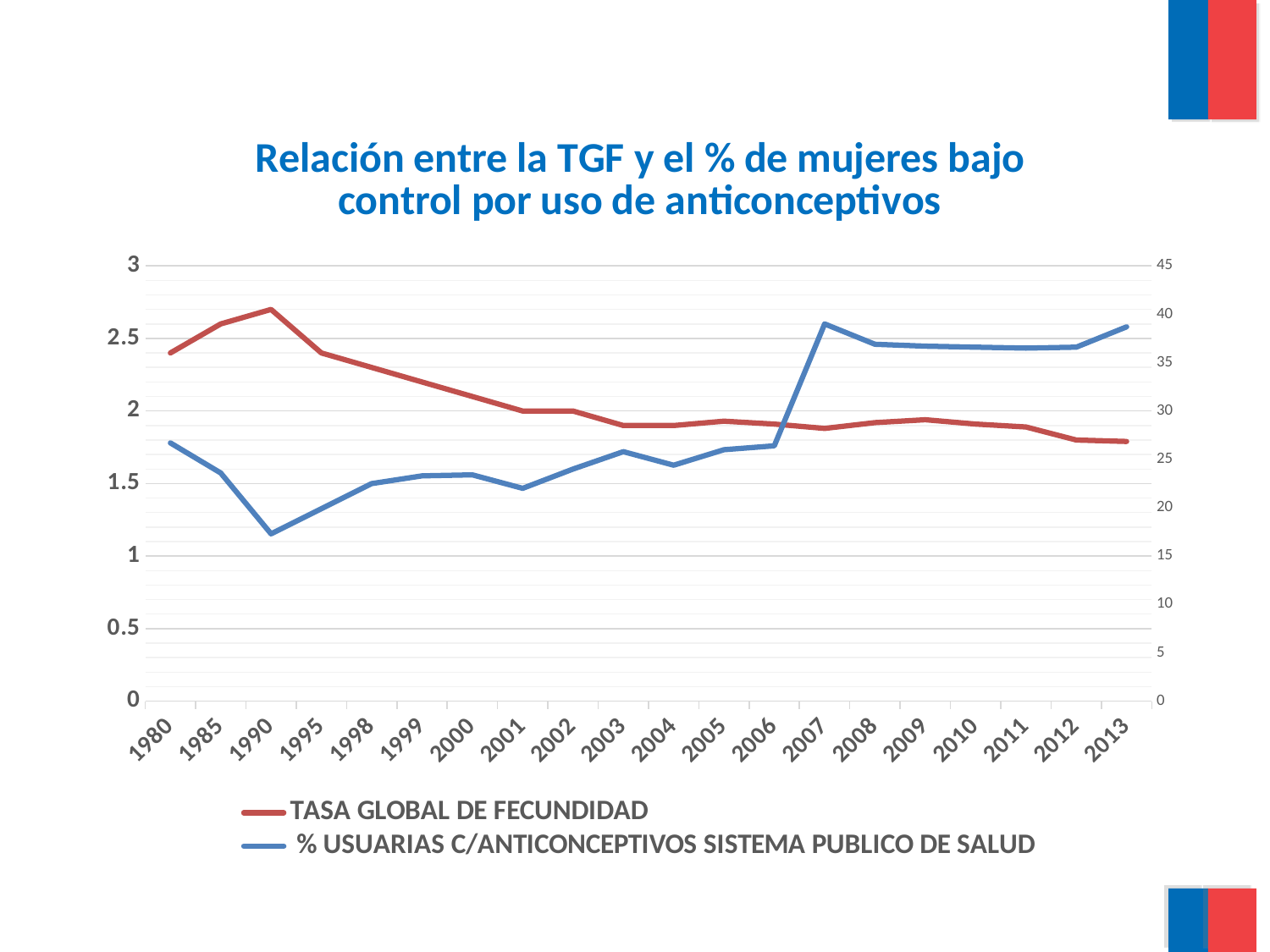
Which year has the larger TASA GLOBAL DE FECUNDIDAD value, 1985 or 2005? 1985 Is the TASA GLOBAL DE FECUNDIDAD value for 2013 greater or less than 2? less In which year does the TASA GLOBAL DE FECUNDIDAD line reach its highest value? 1990 Does the TASA GLOBAL DE FECUNDIDAD line overall rise or fall from 1980 to 2013? fall In which year does the % USUARIAS C/ANTICONCEPTIVOS SISTEMA PUBLICO DE SALUD line reach its lowest value? 1990 Is the % USUARIAS C/ANTICONCEPTIVOS SISTEMA PUBLICO DE SALUD value for 2008 greater or less than 35? greater What colour is the line for % USUARIAS C/ANTICONCEPTIVOS SISTEMA PUBLICO DE SALUD? blue What kind of chart is shown on the slide? line chart Is the % USUARIAS C/ANTICONCEPTIVOS SISTEMA PUBLICO DE SALUD value for 1990 greater or less than 20? less How many series does the legend list? 2 How many years are shown along the x axis? 20